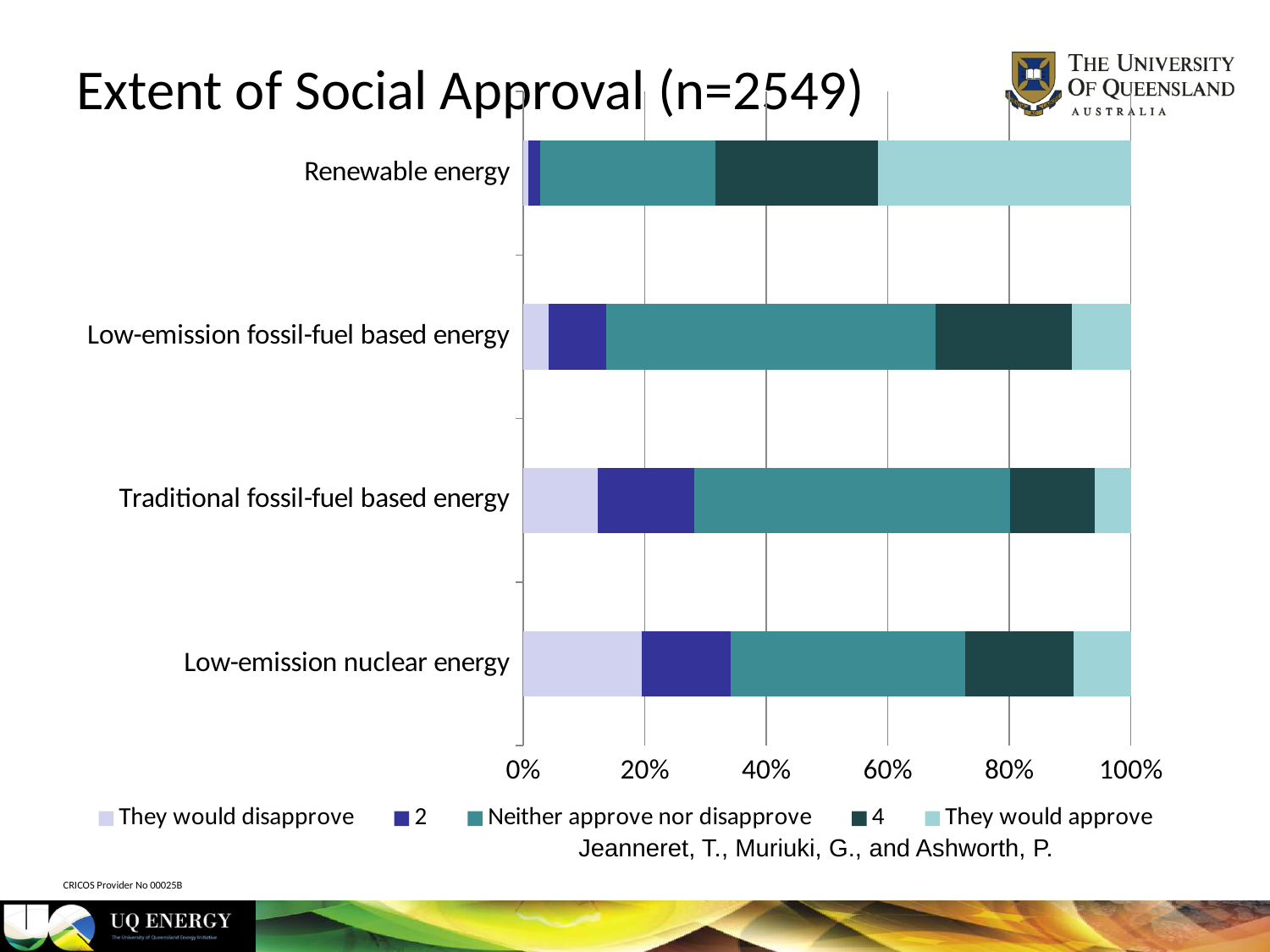
Which energy category has the largest 'They would disapprove' segment? Low-emission nuclear energy Which energy category has the smallest 'They would disapprove' segment? Renewable energy Which energy category has the largest 'They would approve' segment? Renewable energy Is the 'They would approve' share for Renewable energy greater or less than 20%? greater How many series does the legend list? 5 What is the title of the chart? Extent of Social Approval (n=2549) Is the 'Neither approve nor disapprove' share for Traditional fossil-fuel based energy greater or less than 40%? greater What value does each stacked bar total on the x axis? 100% Which has the larger '2' segment: Traditional fossil-fuel based energy or Low-emission fossil-fuel based energy? Traditional fossil-fuel based energy How many energy categories are plotted on the chart? 4 What kind of chart is shown on the slide? Stacked bar chart